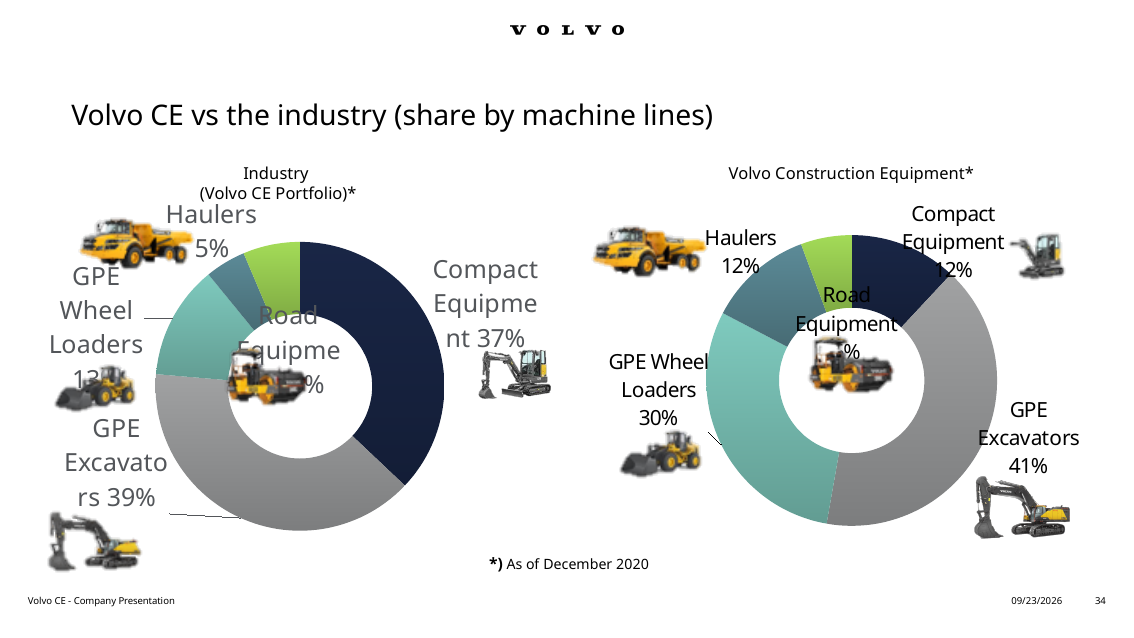
In the Volvo Construction Equipment chart, how many percentage points larger is the GPE Excavators share than the GPE Wheel Loaders share? 11 percentage points In the Volvo Construction Equipment chart, what share do GPE Excavators have? 41% In the Industry (Volvo CE Portfolio) chart, what share do GPE Excavators have? 39% In the Volvo Construction Equipment chart, which machine line has the largest share? GPE Excavators In the Volvo Construction Equipment chart, which machine line has the smallest share? Road Equipment How many machine lines are shown in the Volvo Construction Equipment chart? 5 In the Volvo Construction Equipment chart, what share do Haulers have? 12% Is the Haulers share larger in the Industry (Volvo CE Portfolio) chart or in the Volvo Construction Equipment chart? Volvo Construction Equipment In the Industry (Volvo CE Portfolio) chart, what share do Haulers have? 5% In the Volvo Construction Equipment chart, what share do GPE Wheel Loaders have? 30% In the Industry (Volvo CE Portfolio) chart, what share does Compact Equipment have? 37% What kind of chart is used on this slide? doughnut chart